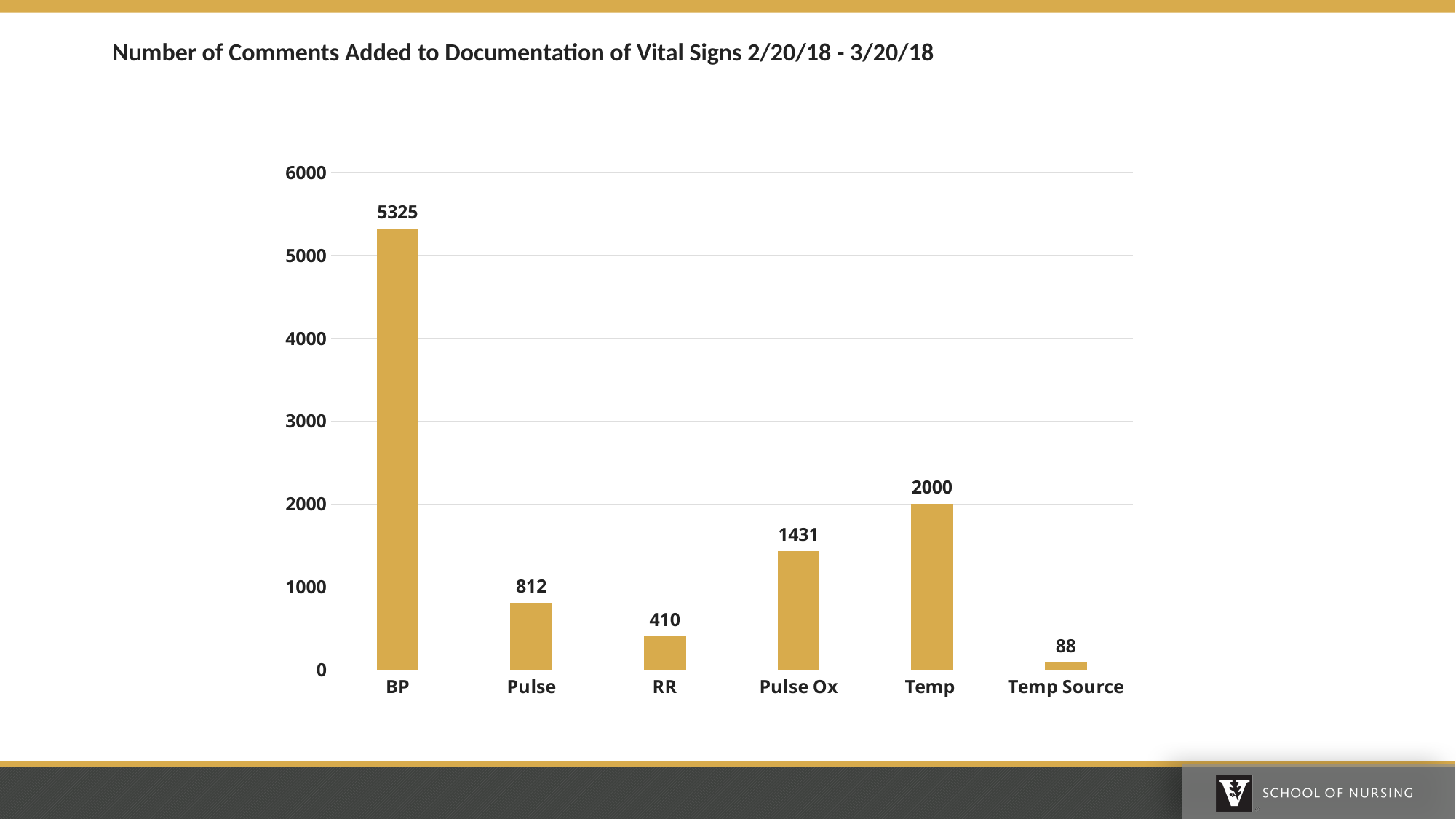
Which has more comments, Pulse or RR? Pulse What is the difference between the number of comments for Temp and for Pulse Ox? 569 Is the value for Pulse Ox greater or less than 1000? greater What is the number of comments for Pulse Ox? 1431 What is the title of the chart? Number of Comments Added to Documentation of Vital Signs 2/20/18 - 3/20/18 How many vital sign categories are shown on the x axis? 6 Which vital sign has the highest number of comments? BP What is the number of comments for BP? 5325 What kind of chart is shown on the slide? bar chart Which vital sign has the lowest number of comments? Temp Source What is the number of comments for Temp Source? 88 What is the difference between the number of comments for Pulse and for RR? 402